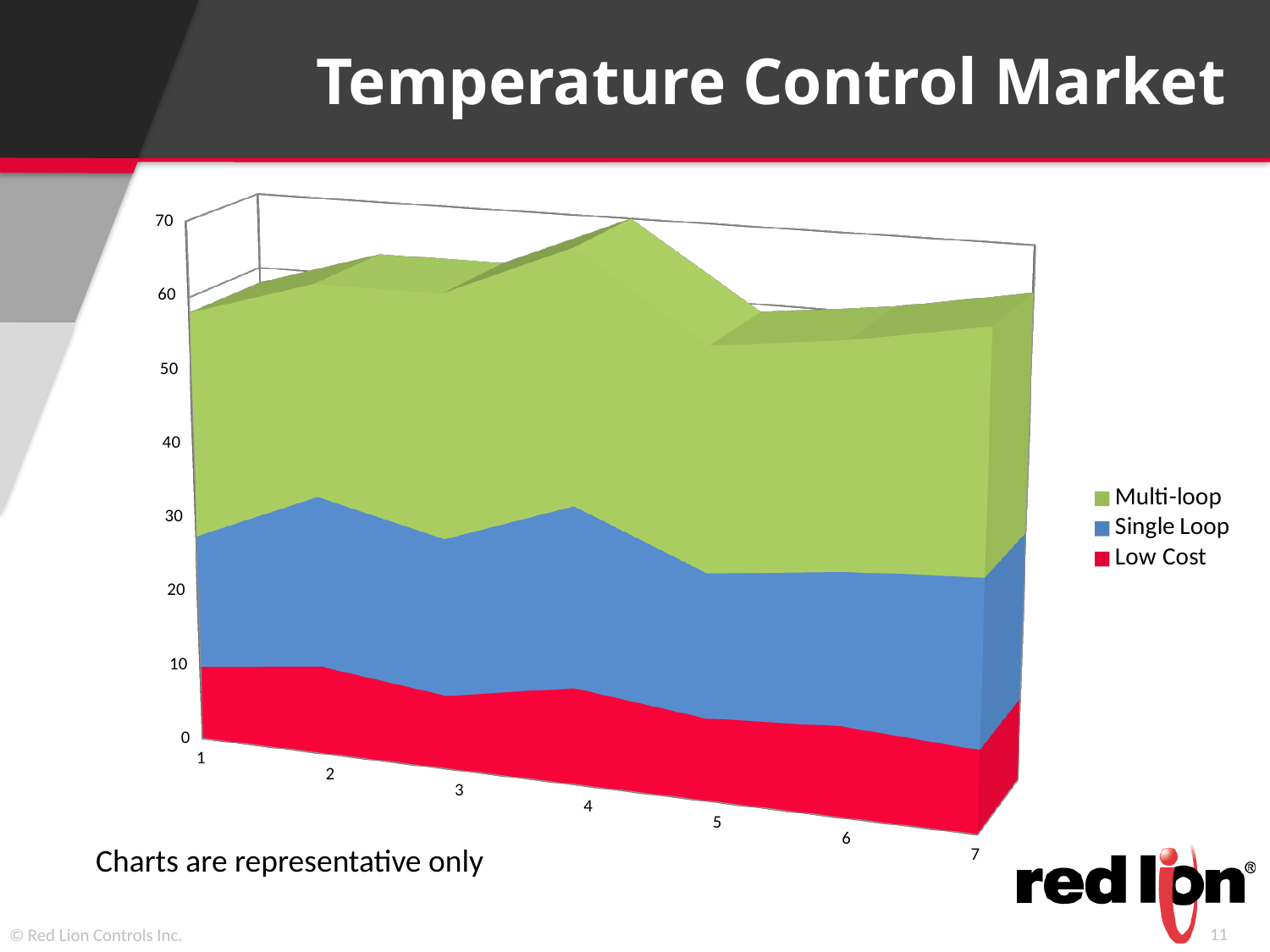
What kind of chart is shown on the slide? Area chart Which is larger: the total stacked value at category 4 or at category 6? Category 4 Which series is shown in red in the chart? Low Cost What is the title of the slide containing the chart? Temperature Control Market How many series does the chart's legend list? 3 Which category has the highest total stacked value in the chart? 4 Is the total stacked value at category 4 greater or less than 60? greater How many categories are shown along the x axis of the chart? 7